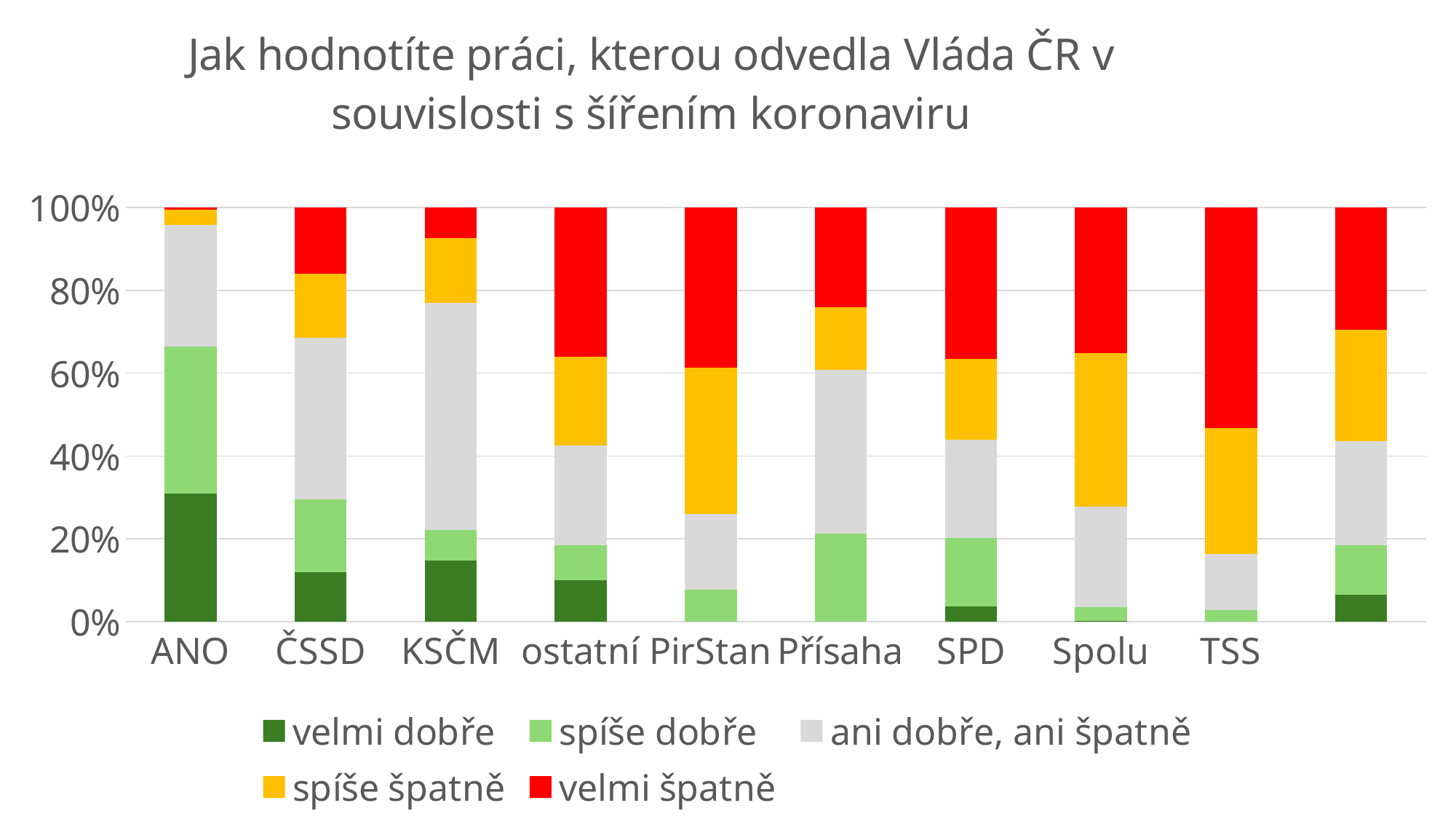
Is the "velmi dobře" share for ANO greater or less than 20%? greater Is the "velmi špatně" share for TSS greater or less than 40%? greater How many bars are plotted in the chart? 10 Which has the larger "velmi špatně" segment, PirStan or Přísaha? PirStan Which category has the largest "ani dobře, ani špatně" segment? KSČM How many series does the legend list? 5 Which category has the largest "velmi dobře" segment? ANO What kind of chart is shown on the slide? stacked bar chart Which category has the largest "velmi špatně" segment? TSS Which category has the smallest "velmi špatně" segment? ANO Is the "velmi dobře" share for SPD greater or less than 10%? less What colour represents "velmi špatně" in the legend? red